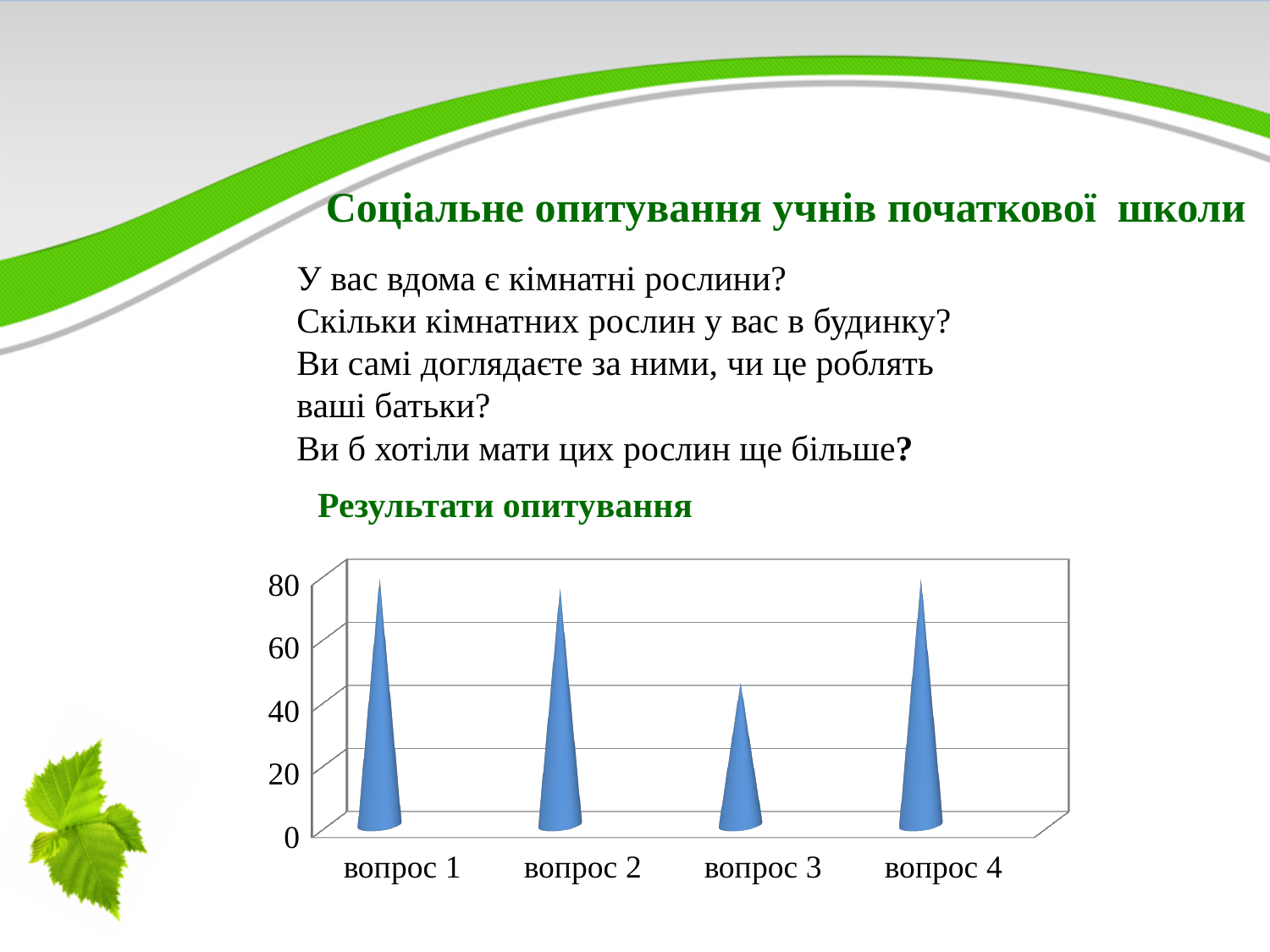
Is the value for вопрос 2 greater or less than 60? greater What heading appears directly above the chart? Результати опитування Is the value for вопрос 3 greater or less than 60? less Which is larger, the value for вопрос 3 or the value for вопрос 4? вопрос 4 Is the value for вопрос 4 greater or less than 40? greater Which category has the lowest value in the chart? вопрос 3 What is the highest tick value shown on the vertical axis of the chart? 80 Which is larger, the value for вопрос 1 or the value for вопрос 3? вопрос 1 How many categories are shown on the x axis of the chart? 4 What kind of chart is shown under "Результати опитування"? bar chart